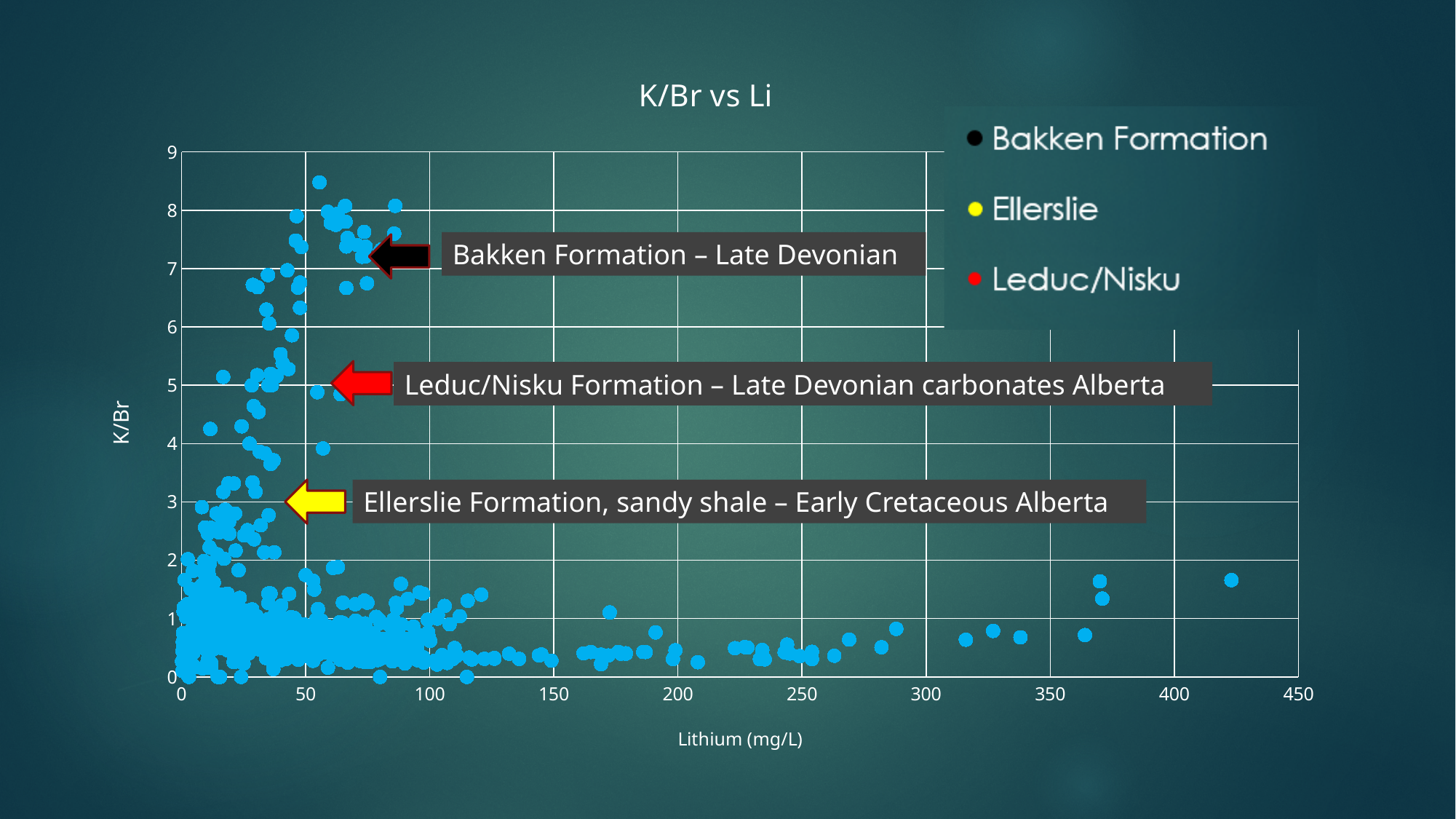
Is the highest K/Br value plotted on the chart greater or less than 8? greater What are the three entries listed in the chart's legend? Bakken Formation, Ellerslie, Leduc/Nisku What is the title of the chart? K/Br vs Li Is the lithium value of the rightmost point on the chart greater or less than 400? greater Do the points with the highest K/Br values occur at low or high lithium concentrations? low For points with lithium above 150 mg/L, are the K/Br values greater or less than 2? less What kind of chart is shown on the slide? scatter chart How many entries does the chart's legend list? 3